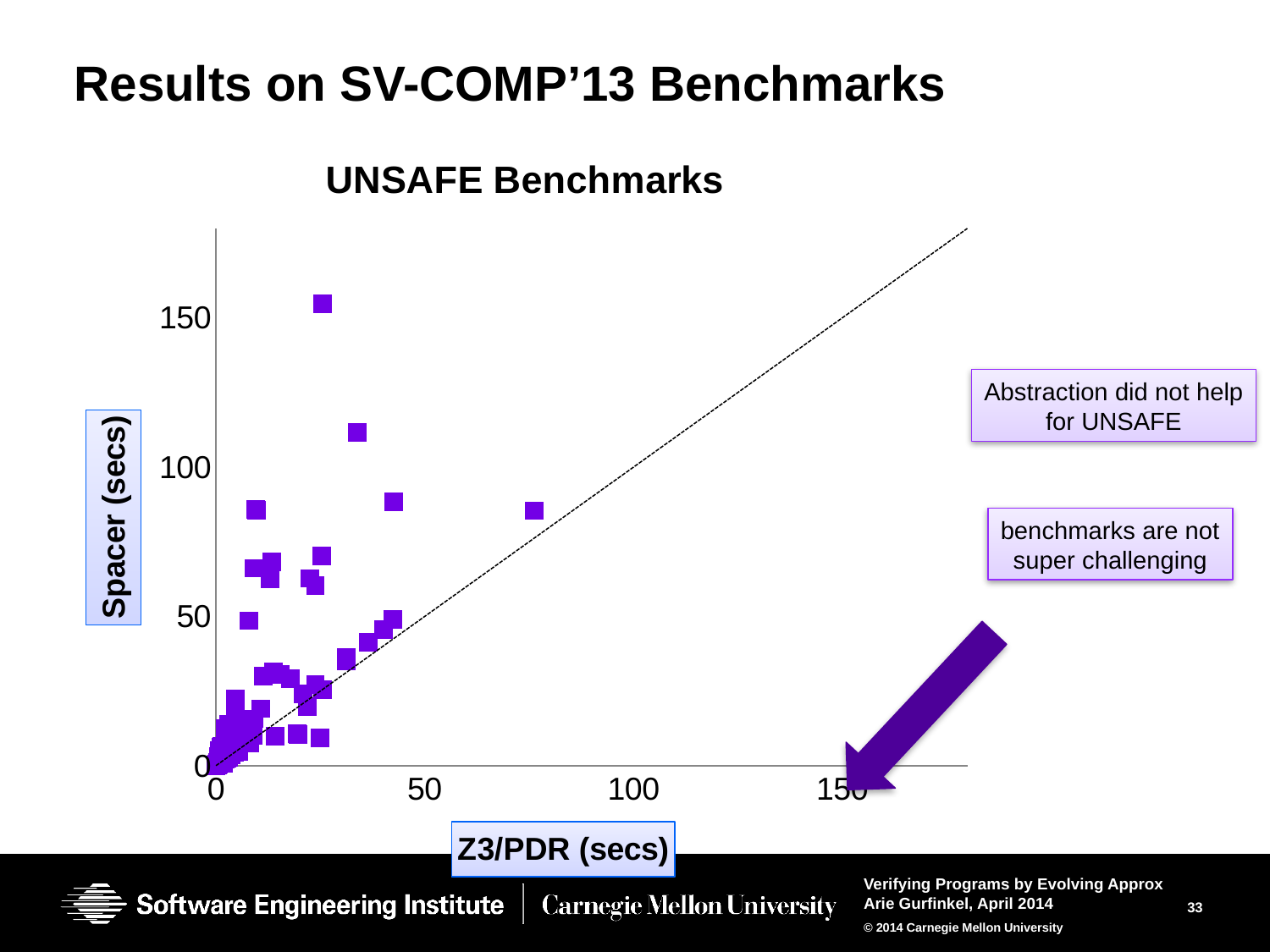
For most of the plotted benchmarks, which is larger: the Spacer time or the Z3/PDR time? Spacer time Is the largest Spacer (secs) value plotted on the chart greater or less than 100? greater For the point with the highest Spacer (secs) value, is its Z3/PDR (secs) value greater or less than 50? less What kind of chart is shown on the slide? scatter chart What is the label of the vertical axis of the chart? Spacer (secs) What is the title of the chart? UNSAFE Benchmarks Is the largest Z3/PDR (secs) value plotted on the chart greater or less than 50? greater